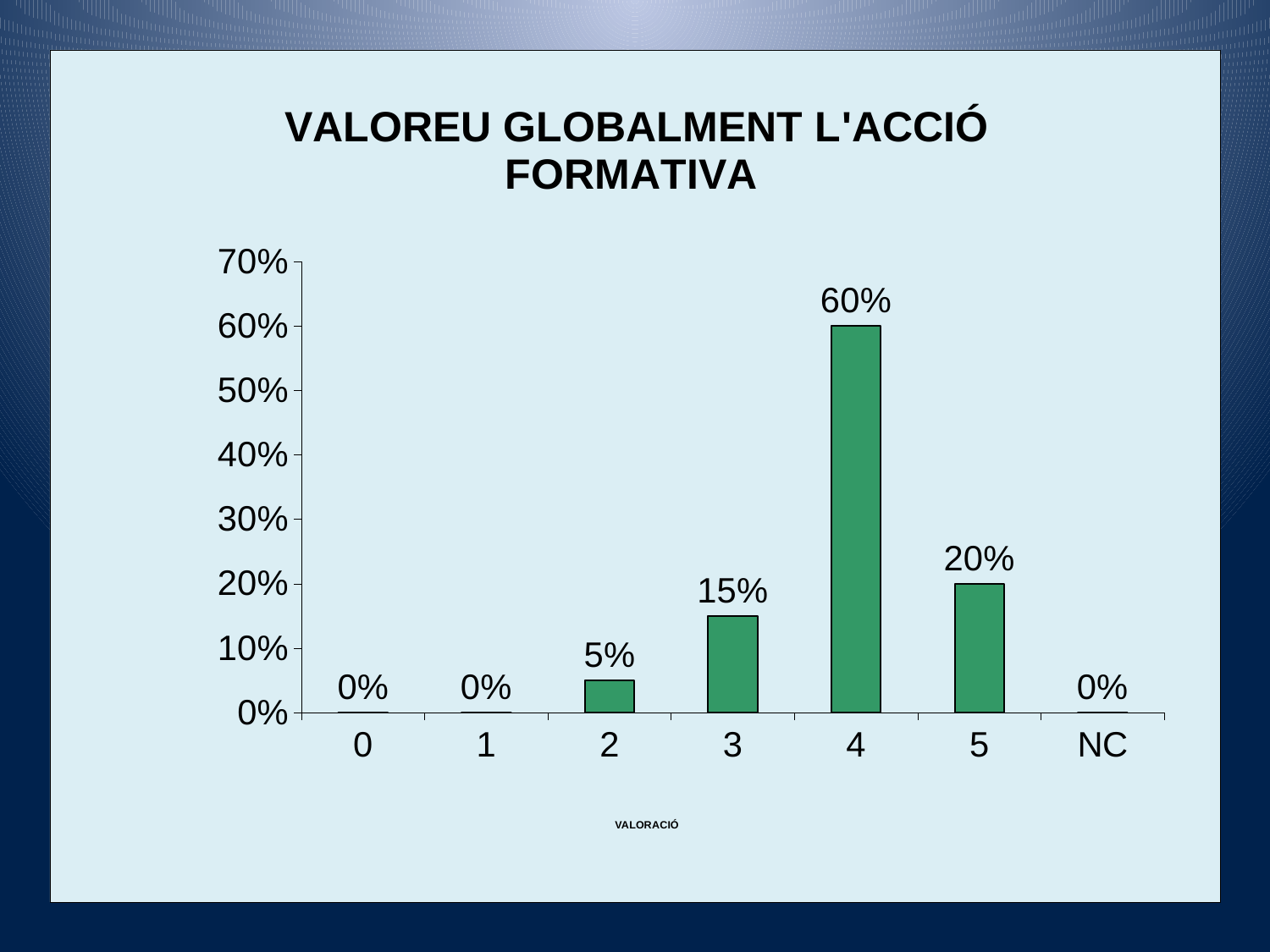
What is the value for category 5? 20% What is the value for category 2? 5% Which is larger, the value for category 3 or the value for category 5? 5 What is the difference between the values for category 3 and category 2? 10% How many categories are shown on the x axis? 7 What is the value for category 4? 60% What is the value for category 3? 15% What is the value for NC? 0% What is the difference between the values for category 4 and category 5? 40% What is the title of the chart? VALOREU GLOBALMENT L'ACCIÓ FORMATIVA What kind of chart is this? bar chart Which category has the highest value? 4